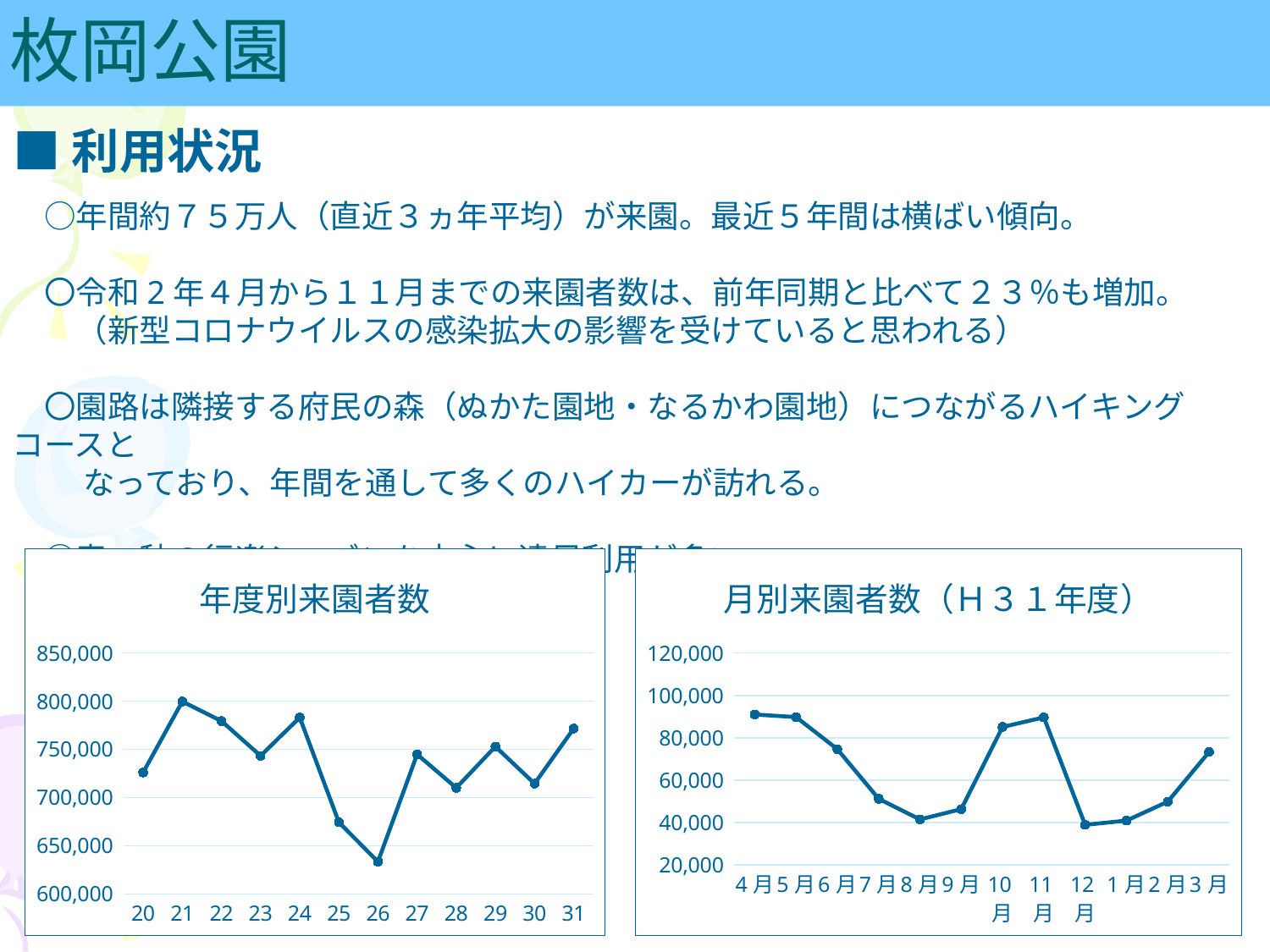
In the 年度別来園者数 chart, which year has the highest number of visitors? 21 In the 月別来園者数（Ｈ３１年度） chart, is the value for 8月 greater or less than 60,000? less How many data points are plotted in the 年度別来園者数 chart? 12 In the 月別来園者数（Ｈ３１年度） chart, which is larger, the value for 4月 or the value for 8月? 4月 What is the title of the chart on the right side of the slide? 月別来園者数（Ｈ３１年度） How many months are plotted in the 月別来園者数（Ｈ３１年度） chart? 12 In the 年度別来園者数 chart, which year has the lowest number of visitors? 26 In the 年度別来園者数 chart, is the value for 21 greater or less than 750,000? greater In the 年度別来園者数 chart, is the value for 26 greater or less than 650,000? less What kind of chart is the 年度別来園者数 chart? line chart In the 年度別来園者数 chart, do the values rise or fall from 24 to 26? fall